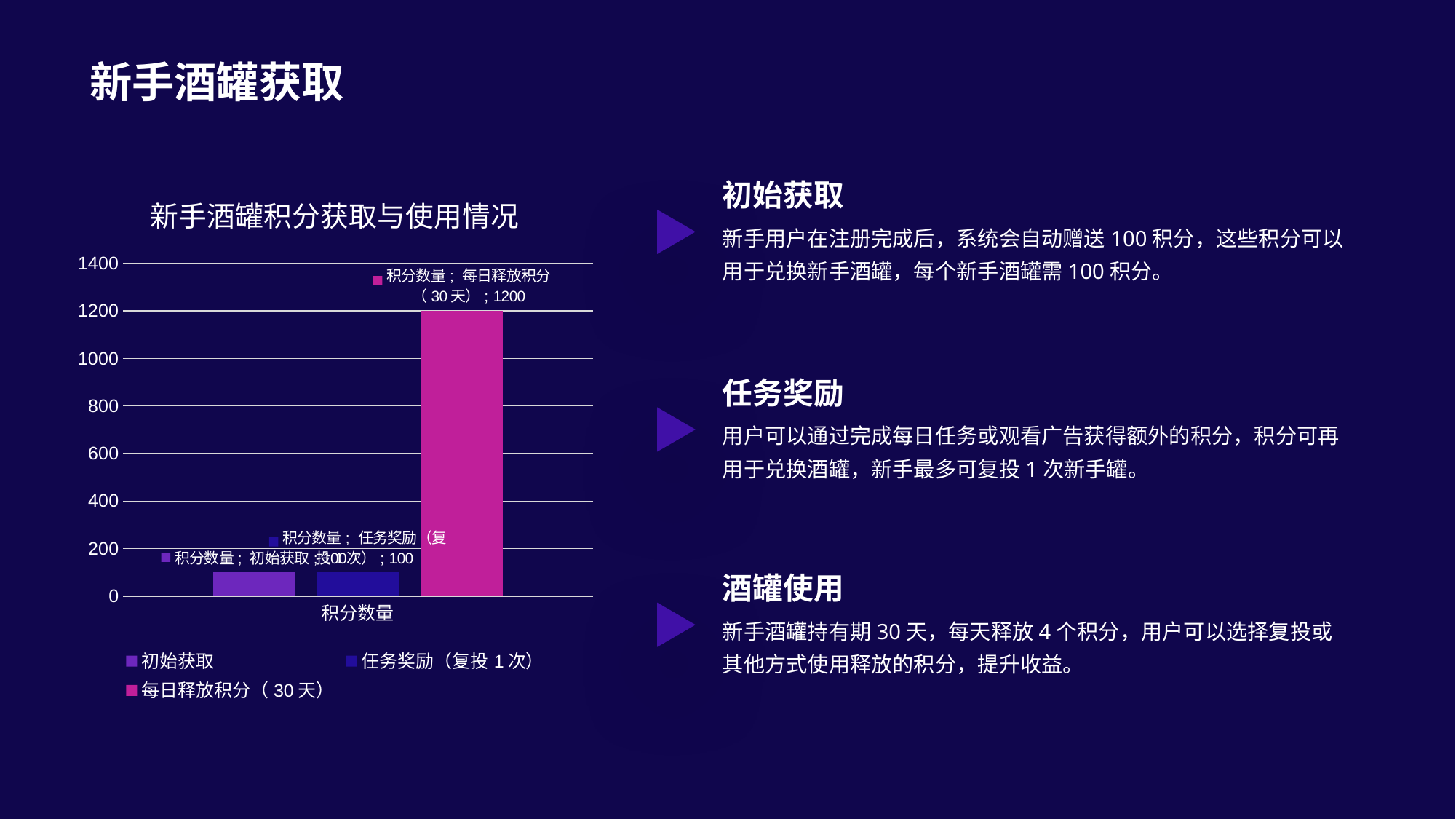
How many categories are shown on the x axis of the chart? 1 Which series has the highest value? 每日释放积分（30 天） How many series does the chart legend list? 3 What is the difference between the value for 每日释放积分（30 天） and the value for 任务奖励（复投 1 次）? 1100 What is the value for 初始获取? 100 What kind of chart is shown on the slide? bar chart What is the value for 每日释放积分（30 天）? 1200 What is the title of the chart? 新手酒罐积分获取与使用情况 Is the value for 每日释放积分（30 天） greater or less than 1000? greater Which is larger, the value for 每日释放积分（30 天） or the value for 初始获取? 每日释放积分（30 天） What is the value for 任务奖励（复投 1 次）? 100 What colour is the bar for 每日释放积分（30 天）? magenta